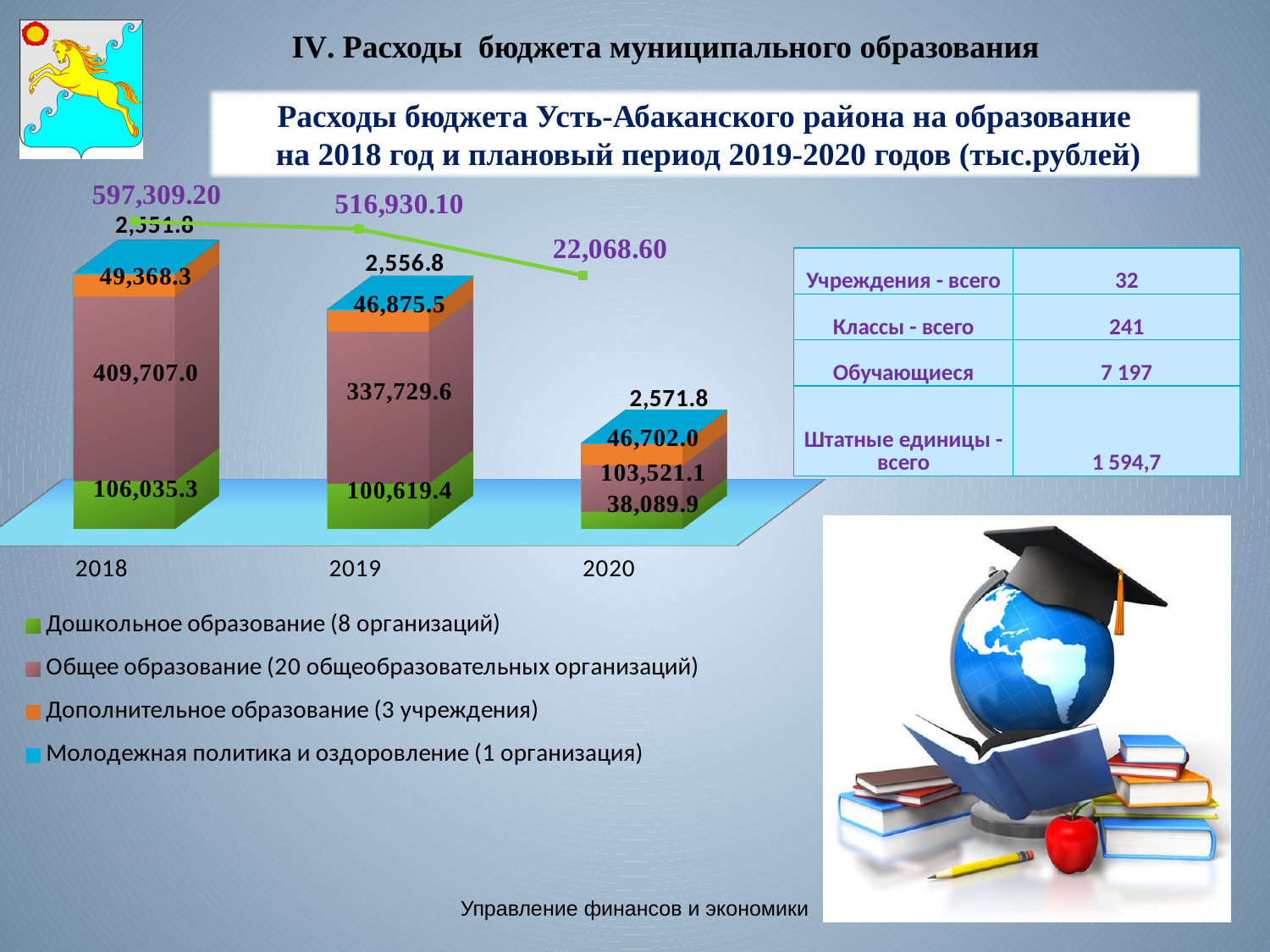
What is the difference between the Дошкольное образование values for 2018 and 2019? 5,415.9 What is the value for Молодежная политика и оздоровление in 2020? 2,571.8 In which year is the value for Дошкольное образование the lowest? 2020 What is the value for Общее образование in 2018? 409,707.0 What is the value for Дополнительное образование in 2019? 46,875.5 How many years are shown on the x axis of the chart? 3 What value is labelled on the line above the 2019 bar? 516,930.10 In which year is the value for Общее образование the highest? 2018 How many series does the chart legend list? 4 Which is larger: the Общее образование value for 2019 or for 2020? 2019 What kind of chart is shown on the slide? Stacked bar chart What is the value for Дошкольное образование in 2020? 38,089.9